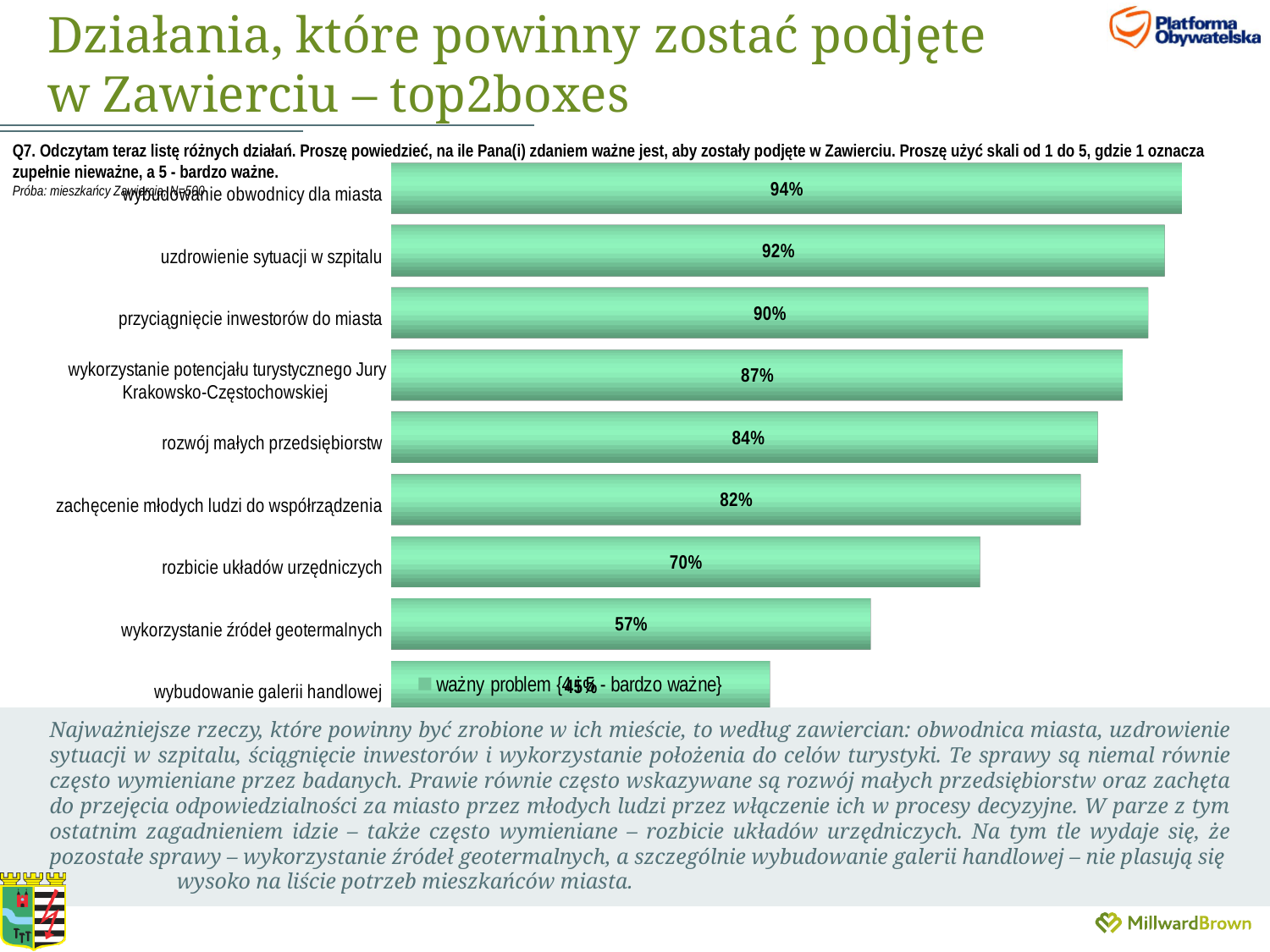
Which category has the highest value? wybudowanie obwodnicy dla miasta How many categories are shown in the chart? 9 What type of chart is shown on the slide? bar chart What is the value for "rozbicie układów urzędniczych"? 70% What is the value for "wykorzystanie źródeł geotermalnych"? 57% What is the difference between the values for "rozwój małych przedsiębiorstw" and "zachęcenie młodych ludzi do współrządzenia"? 2% What is the value for "uzdrowienie sytuacji w szpitalu"? 92% What is the value for "wybudowanie obwodnicy dla miasta"? 94% Which category has the lowest value? wybudowanie galerii handlowej Which is larger: the value for "rozbicie układów urzędniczych" or the value for "wykorzystanie źródeł geotermalnych"? rozbicie układów urzędniczych What is the value for "wykorzystanie potencjału turystycznego Jury Krakowsko-Częstochowskiej"? 87% What is the value for "przyciągnięcie inwestorów do miasta"? 90%